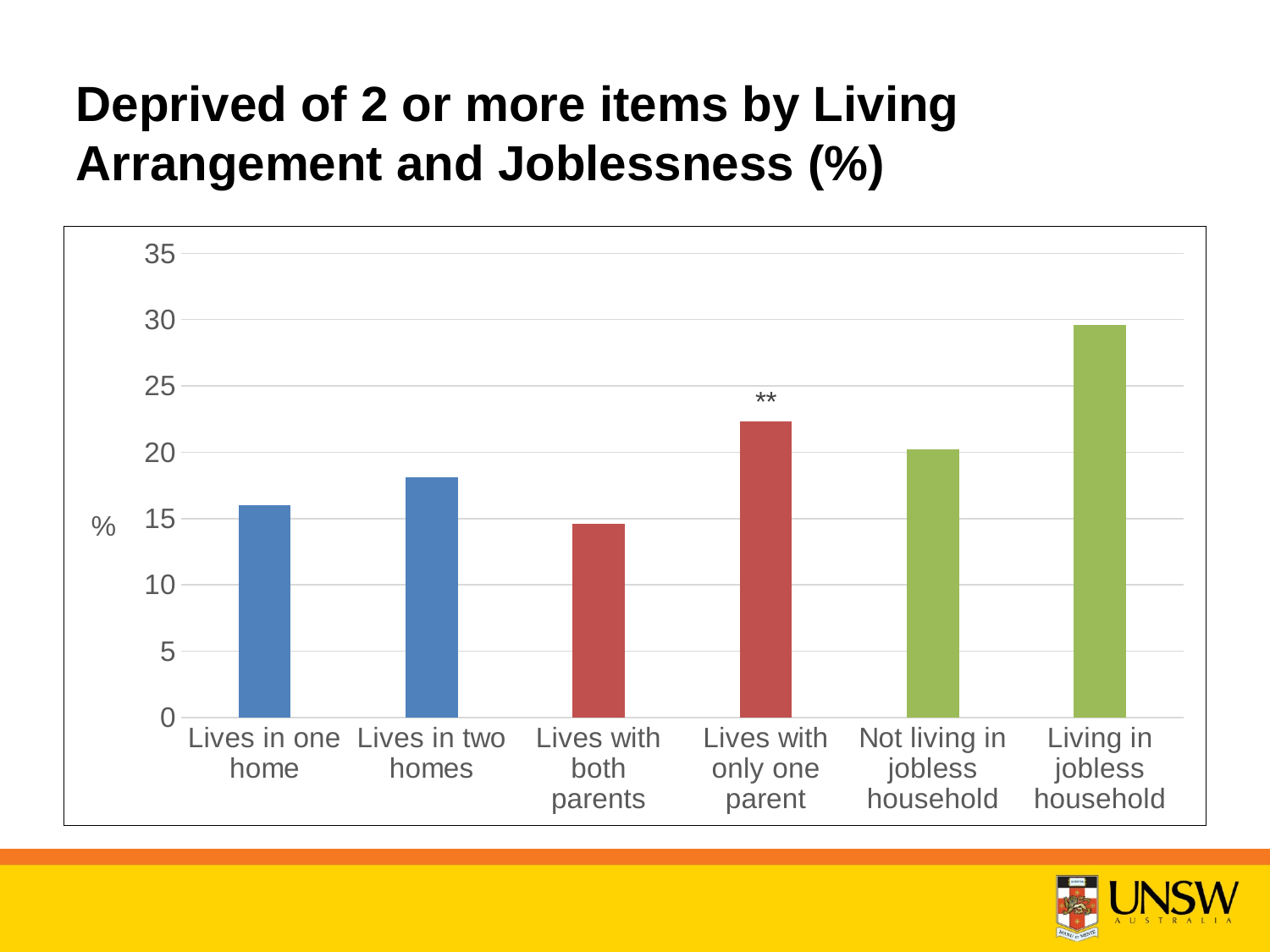
What is the title of the chart on the slide? Deprived of 2 or more items by Living Arrangement and Joblessness (%) How many categories are shown on the x axis of the chart? 6 Which category has the lowest value in the chart? Lives with both parents Which category has the highest value in the chart? Living in jobless household What kind of chart is shown on the slide? bar chart Which is larger, the value for 'Lives in one home' or the value for 'Lives in two homes'? Lives in two homes Which is larger, the value for 'Not living in jobless household' or the value for 'Living in jobless household'? Living in jobless household Is the value for 'Lives in two homes' greater or less than 20? less Which category's bar is marked with '**' above it? Lives with only one parent Is the value for 'Lives with only one parent' greater or less than 20? greater Is the value for 'Living in jobless household' greater or less than 25? greater